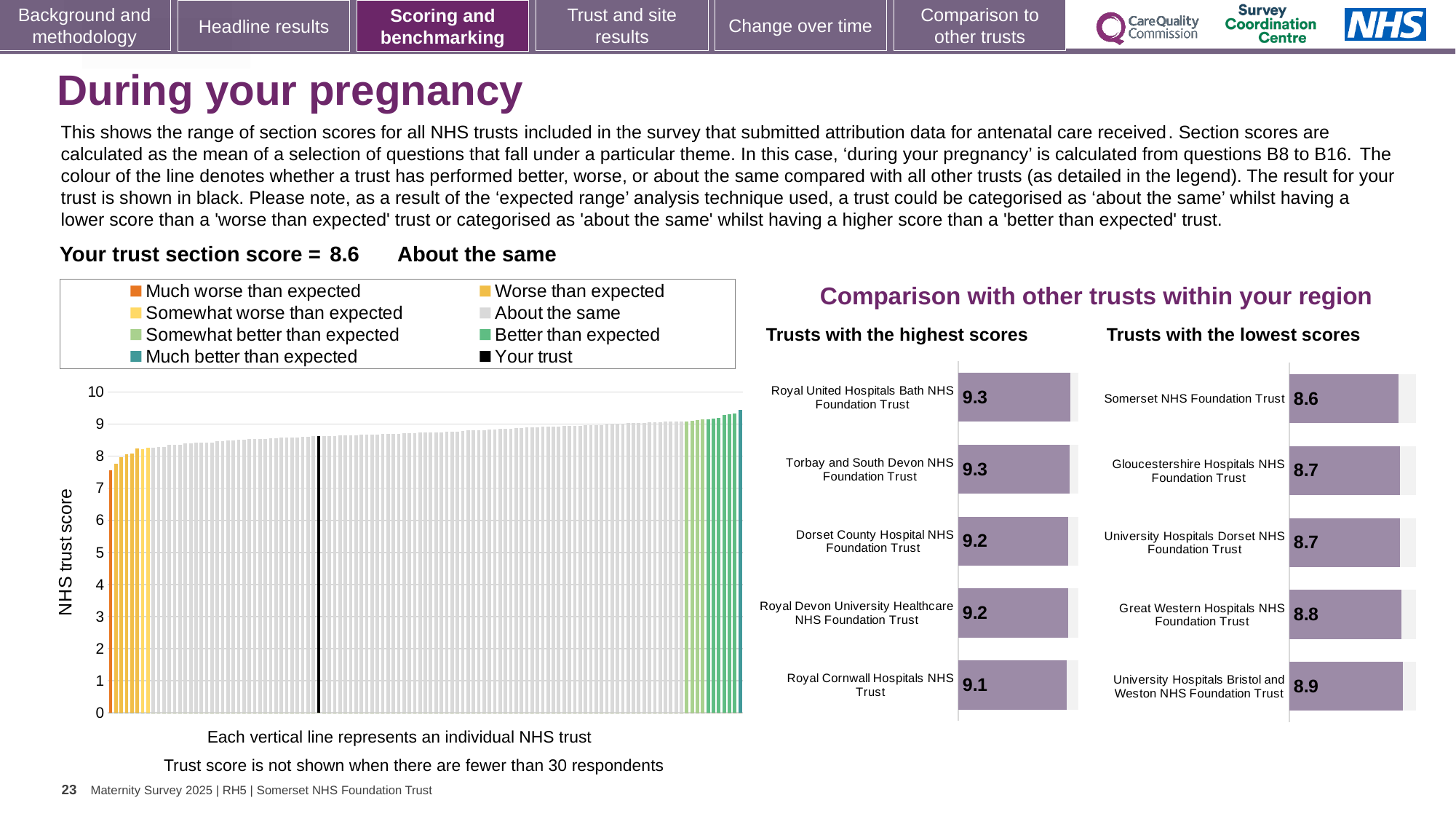
Comparing the two regional charts, which has the higher score: Dorset County Hospital NHS Foundation Trust or Gloucestershire Hospitals NHS Foundation Trust? Dorset County Hospital NHS Foundation Trust In the 'Trusts with the highest scores' chart, what is the difference between the scores of Royal United Hospitals Bath NHS Foundation Trust and Royal Cornwall Hospitals NHS Trust? 0.2 How many trusts are shown in the 'Trusts with the highest scores' chart? 5 In the 'Trusts with the lowest scores' chart, which trust has the highest score? University Hospitals Bristol and Weston NHS Foundation Trust In the main 'NHS trust score' chart, do the bar heights rise or fall from left to right? Rise In the 'Trusts with the highest scores' chart, what is the score for Royal Cornwall Hospitals NHS Trust? 9.1 What kind of chart is the main chart on the left showing NHS trust scores? Bar chart How many entries does the legend of the main 'NHS trust score' chart list? 8 In the 'Trusts with the highest scores' chart, which trust has the lowest score? Royal Cornwall Hospitals NHS Trust In the 'Trusts with the lowest scores' chart, which trust has the lowest score? Somerset NHS Foundation Trust In the 'Trusts with the lowest scores' chart, what is the difference between the scores of University Hospitals Bristol and Weston NHS Foundation Trust and Somerset NHS Foundation Trust? 0.3 In the 'Trusts with the lowest scores' chart, what is the score for Great Western Hospitals NHS Foundation Trust? 8.8